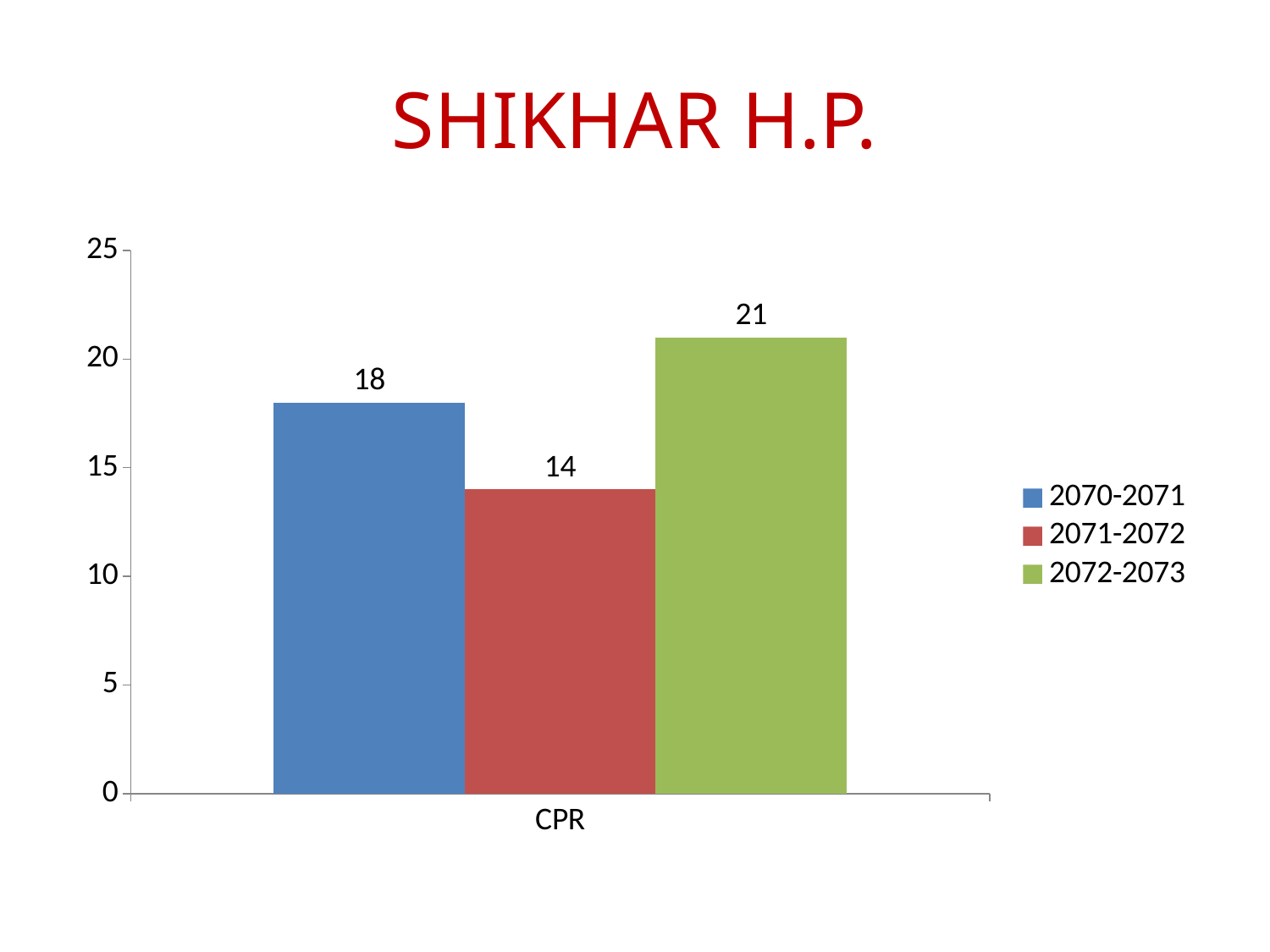
What is the difference between the CPR values for 2072-2073 and 2071-2072? 7 How many series does the legend list? 3 What is the difference between the CPR values for 2070-2071 and 2071-2072? 4 What is the CPR value for 2070-2071? 18 Which is larger, the CPR value for 2070-2071 or for 2072-2073? 2072-2073 Which series has the highest CPR value? 2072-2073 What is the CPR value for 2072-2073? 21 What is the title of the slide? SHIKHAR H.P. What kind of chart is shown on the slide? bar chart What is the CPR value for 2071-2072? 14 Which series has the lowest CPR value? 2071-2072 Is the CPR value for 2071-2072 greater or less than 15? less